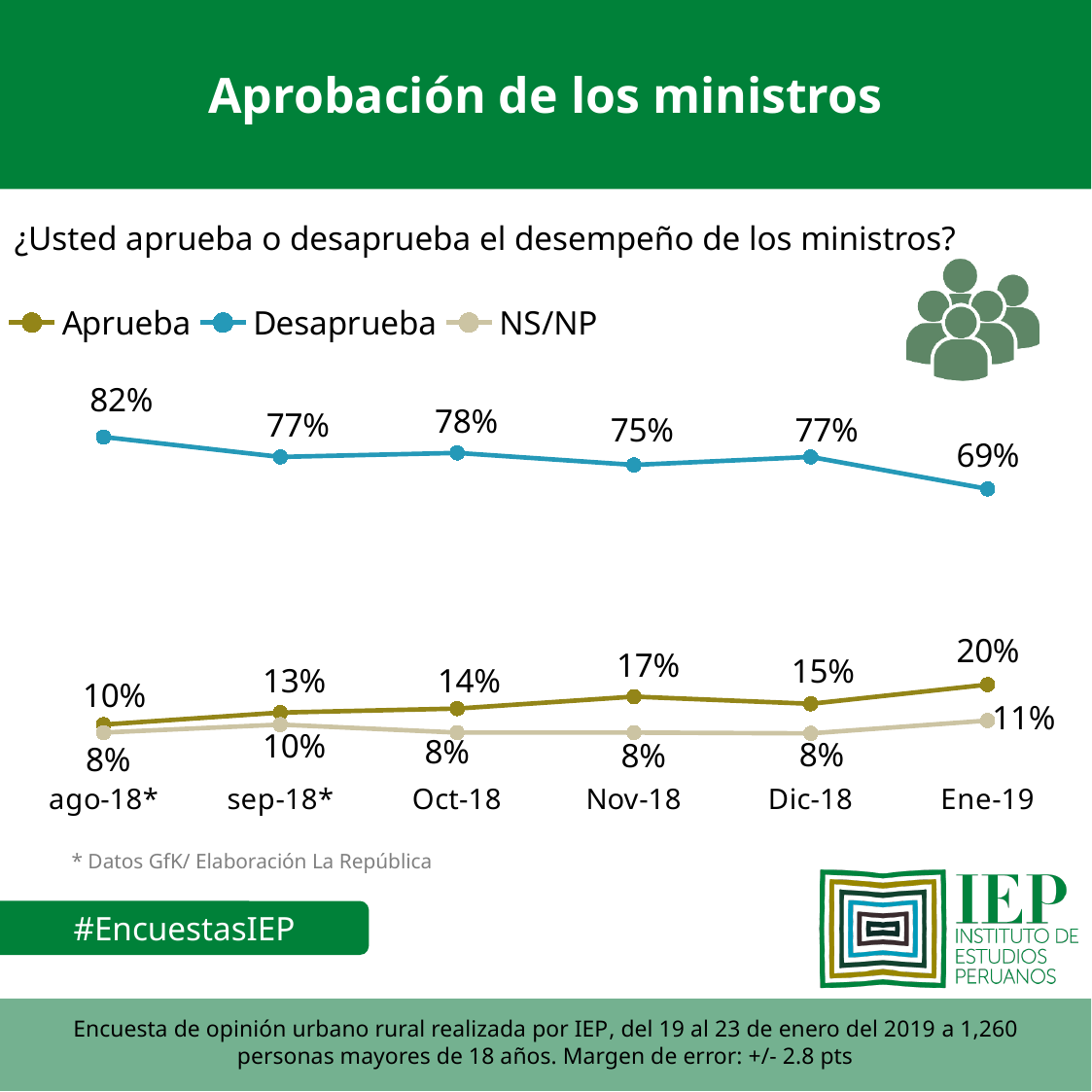
What is the difference between the Desaprueba values in ago-18* and Ene-19? 13% What is the title of the chart? Aprobación de los ministros In which month is the Aprueba value highest? Ene-19 Does the Desaprueba series generally rise or fall from ago-18* to Ene-19? fall How many time points are plotted on the x axis? 6 What kind of chart is shown on the slide? line chart What is the value for Aprueba in Ene-19? 20% What is the value for Desaprueba in ago-18*? 82% Which is larger in Nov-18, Aprueba or NS/NP? Aprueba How many series does the legend list? 3 In which month is the Desaprueba value lowest? Ene-19 What is the value for NS/NP in sep-18*? 10%